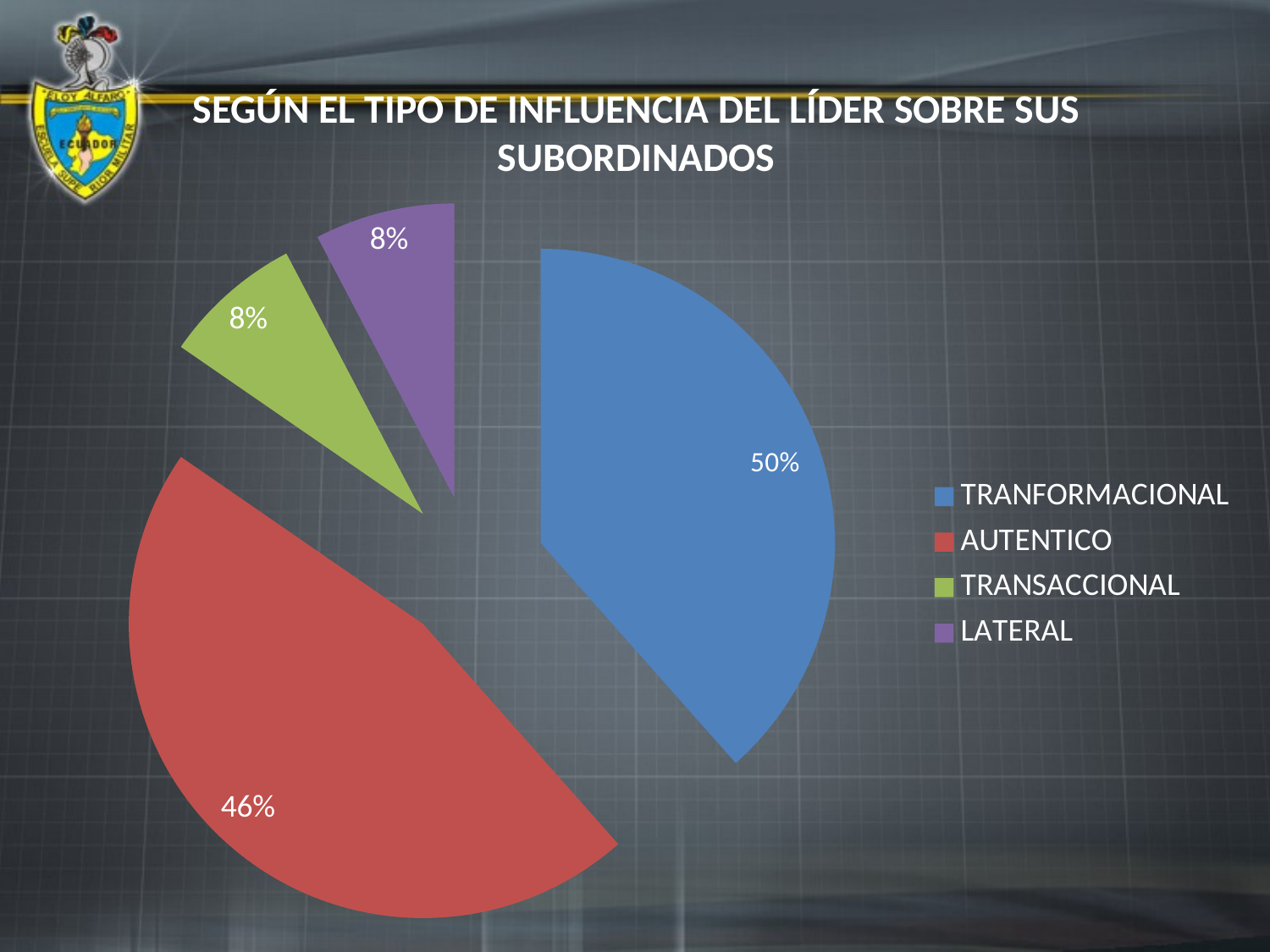
What percentage is shown for TRANSACCIONAL? 8% What percentage is shown for AUTENTICO? 46% What percentage is shown for LATERAL? 8% What percentage is shown for TRANFORMACIONAL? 50% What kind of chart is shown on the slide? pie chart What is the combined share of TRANSACCIONAL and LATERAL? 16% Which is larger, the share for AUTENTICO or the share for TRANSACCIONAL? AUTENTICO What is the title of the chart? SEGÚN EL TIPO DE INFLUENCIA DEL LÍDER SOBRE SUS SUBORDINADOS How many categories does the legend list? 4 What colour is the slice for AUTENTICO? red